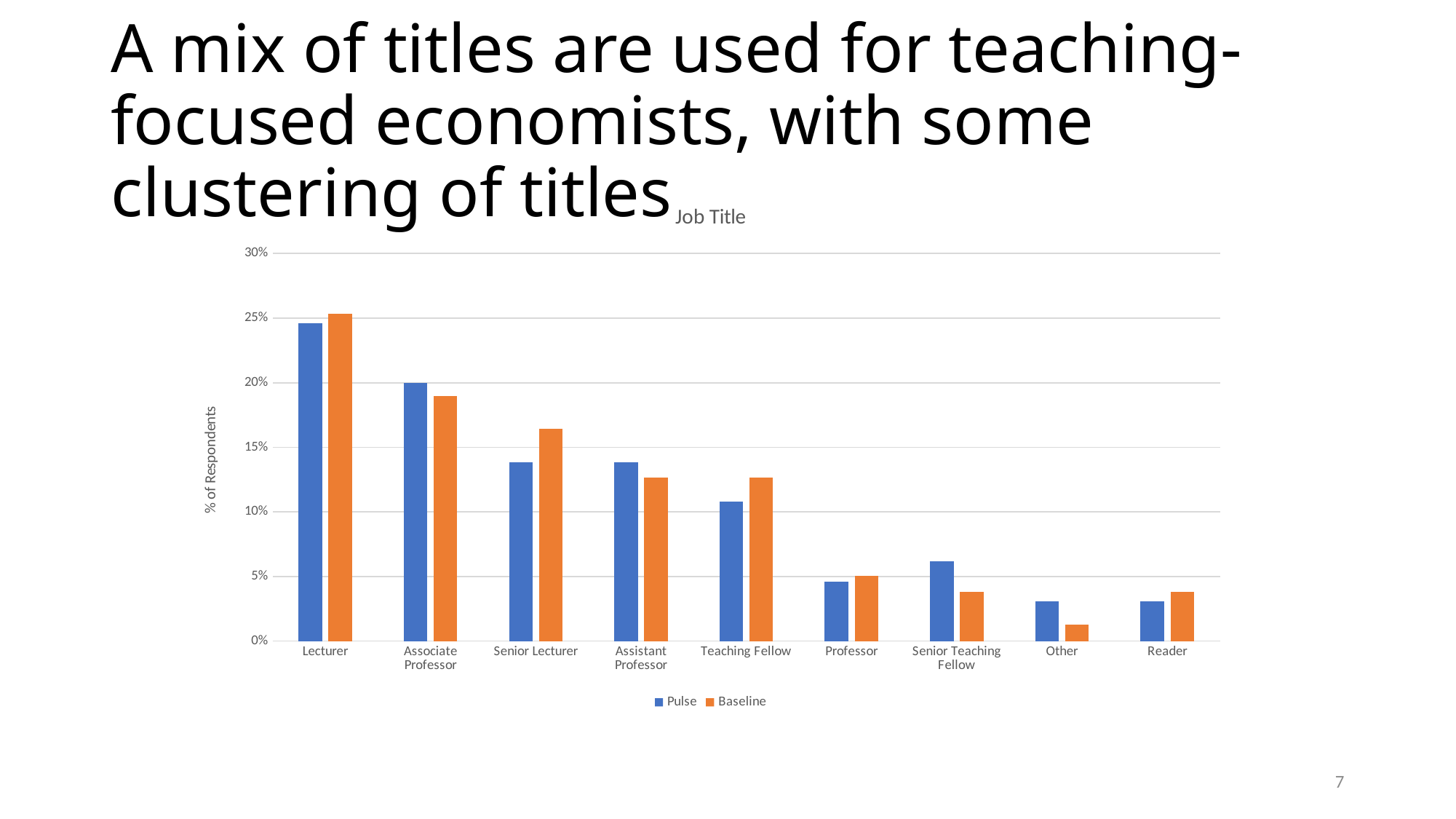
What kind of chart is shown on the slide? Bar chart What is the label on the vertical axis of the chart? % of Respondents How many series does the legend list? 2 Which job title has the lowest Baseline value? Other For Senior Lecturer, which series has the larger value, Pulse or Baseline? Baseline Which job title has the highest Pulse value? Lecturer Is the Pulse value for Lecturer greater or less than 20%? greater Is the Baseline value for Senior Lecturer greater or less than 15%? greater For Senior Teaching Fellow, which series has the larger value, Pulse or Baseline? Pulse How many job title categories are shown on the x axis? 9 Is the Baseline value for Other greater or less than 5%? less Do the Pulse values generally rise or fall moving from left to right along the x axis? Fall